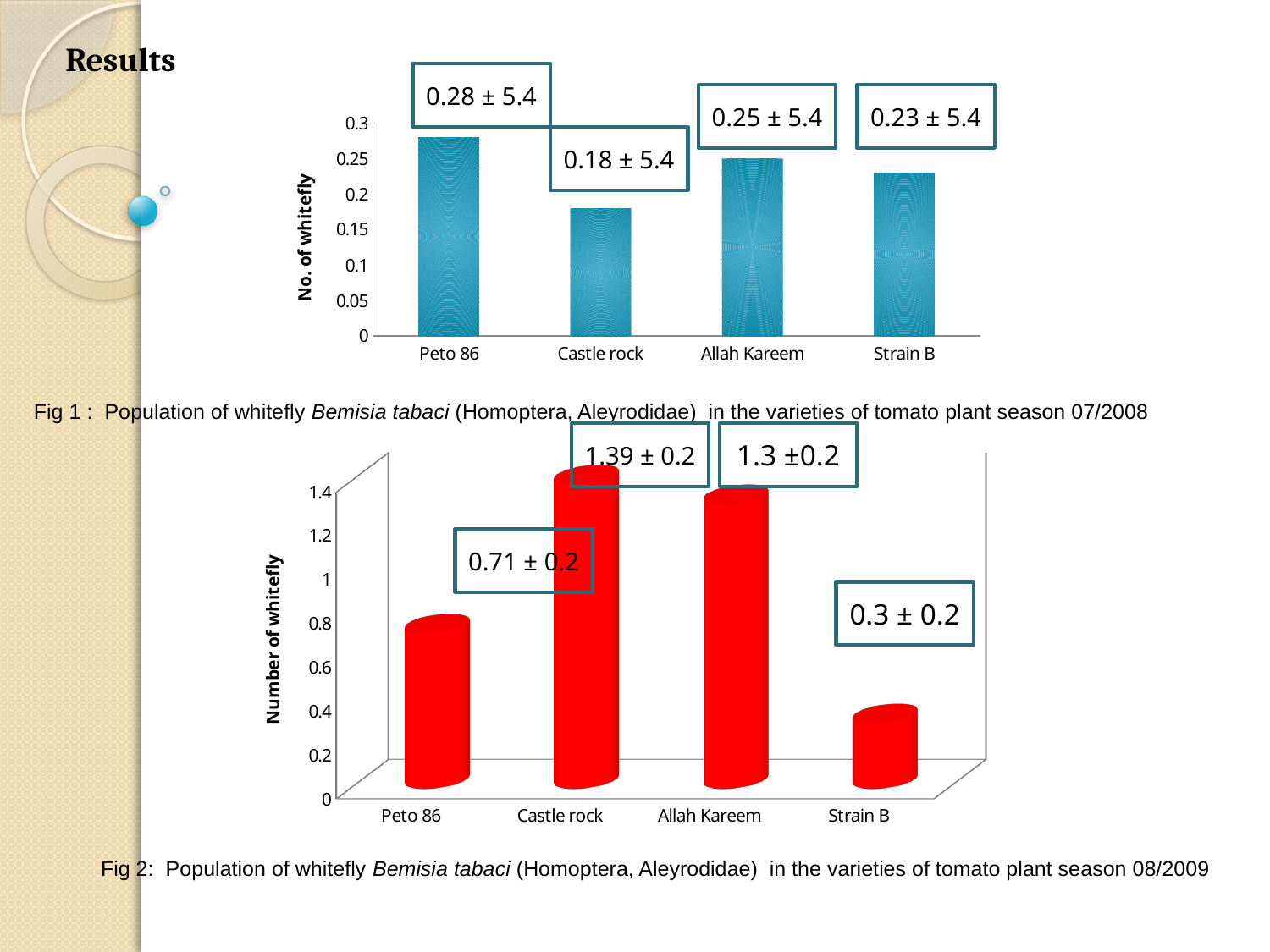
What type of chart is Fig 2 (bottom chart, season 08/2009)? Bar chart In Fig 1 (top chart, season 07/2008), which variety has the highest number of whitefly? Peto 86 In Fig 2 (bottom chart, season 08/2009), which variety has the lowest number of whitefly? Strain B In Fig 1 (top chart, season 07/2008), how many tomato varieties are plotted? 4 In Fig 2 (bottom chart, season 08/2009), what is the difference between the mean values for Castle rock and Strain B? 1.09 In Fig 1 (top chart, season 07/2008), what is the difference between the mean values for Peto 86 and Castle rock? 0.1 In Fig 1 (top chart, season 07/2008), what value is labelled for Peto 86? 0.28 ± 5.4 In Fig 2 (bottom chart, season 08/2009), what value is labelled for Castle rock? 1.39 ± 0.2 In Fig 2 (bottom chart, season 08/2009), what value is labelled for Strain B? 0.3 ± 0.2 In Fig 2 (bottom chart, season 08/2009), which is larger, the value for Peto 86 or the value for Allah Kareem? Allah Kareem In Fig 1 (top chart, season 07/2008), what value is labelled for Castle rock? 0.18 ± 5.4 In Fig 1 (top chart, season 07/2008), which variety has the lowest number of whitefly? Castle rock